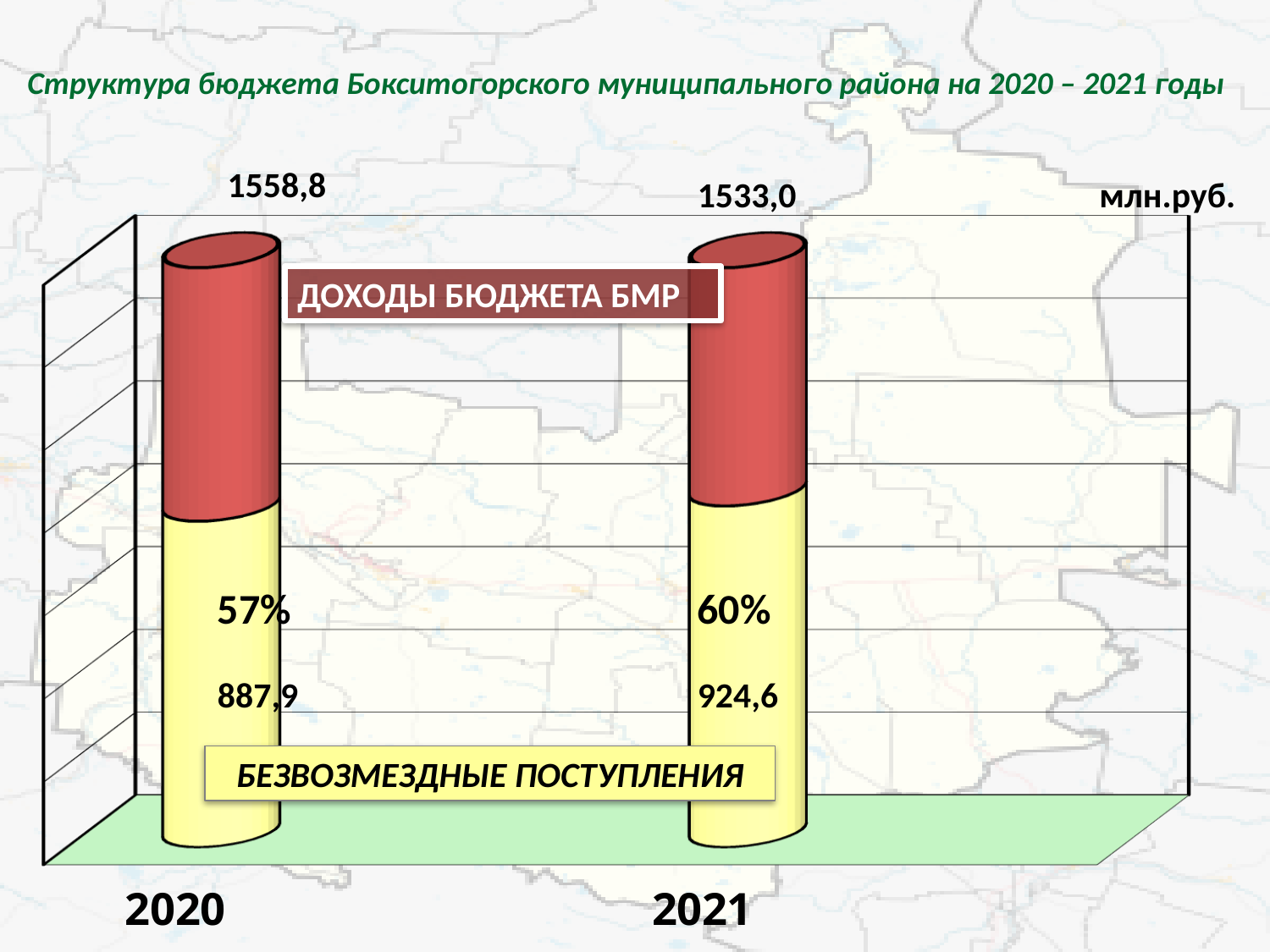
What is the total budget revenue (ДОХОДЫ БЮДЖЕТА БМР) shown for 2020? 1558,8 What is the value of БЕЗВОЗМЕЗДНЫЕ ПОСТУПЛЕНИЯ for 2020? 887,9 What share of budget revenue do БЕЗВОЗМЕЗДНЫЕ ПОСТУПЛЕНИЯ make up in 2021? 60% How many years (categories) are plotted on the chart? 2 What is the value of БЕЗВОЗМЕЗДНЫЕ ПОСТУПЛЕНИЯ for 2021? 924,6 By how much does the total budget revenue in 2020 exceed that in 2021? 25,8 In what units are the values on the chart given? млн.руб. What is the total budget revenue (ДОХОДЫ БЮДЖЕТА БМР) shown for 2021? 1533,0 By how much do БЕЗВОЗМЕЗДНЫЕ ПОСТУПЛЕНИЯ in 2021 exceed those in 2020? 36,7 What kind of chart is shown on the slide? Stacked bar chart What share of budget revenue do БЕЗВОЗМЕЗДНЫЕ ПОСТУПЛЕНИЯ make up in 2020? 57% Which year has the higher total budget revenue, 2020 or 2021? 2020